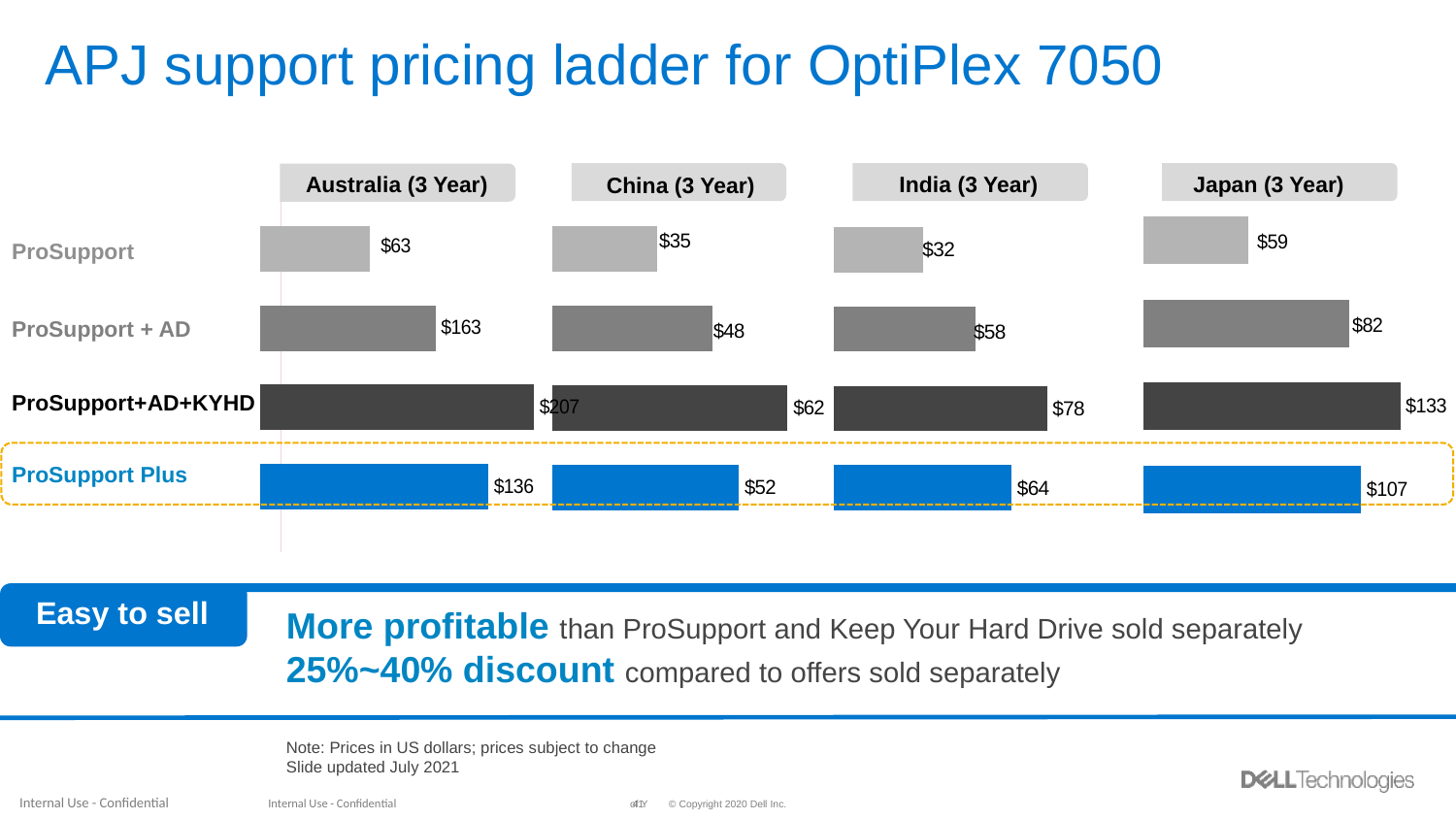
How many categories are shown in the Japan (3 Year) chart? 4 In the China (3 Year) chart, which is larger: ProSupport Plus or ProSupport + AD? ProSupport Plus In the China (3 Year) chart, what is the value for ProSupport + AD? $48 What type of chart is used for the China (3 Year) data? Bar chart In the Japan (3 Year) chart, what is the difference between ProSupport+AD+KYHD and ProSupport Plus? $26 In the India (3 Year) chart, what is the value for ProSupport+AD+KYHD? $78 In the India (3 Year) chart, which is larger: ProSupport Plus or ProSupport + AD? ProSupport Plus In the Australia (3 Year) chart, what is the value for ProSupport Plus? $136 In the Japan (3 Year) chart, what is the value for ProSupport? $59 In the Australia (3 Year) chart, what is the difference between ProSupport + AD and ProSupport? $100 In the Australia (3 Year) chart, which category has the highest value? ProSupport+AD+KYHD In the India (3 Year) chart, which category has the lowest value? ProSupport